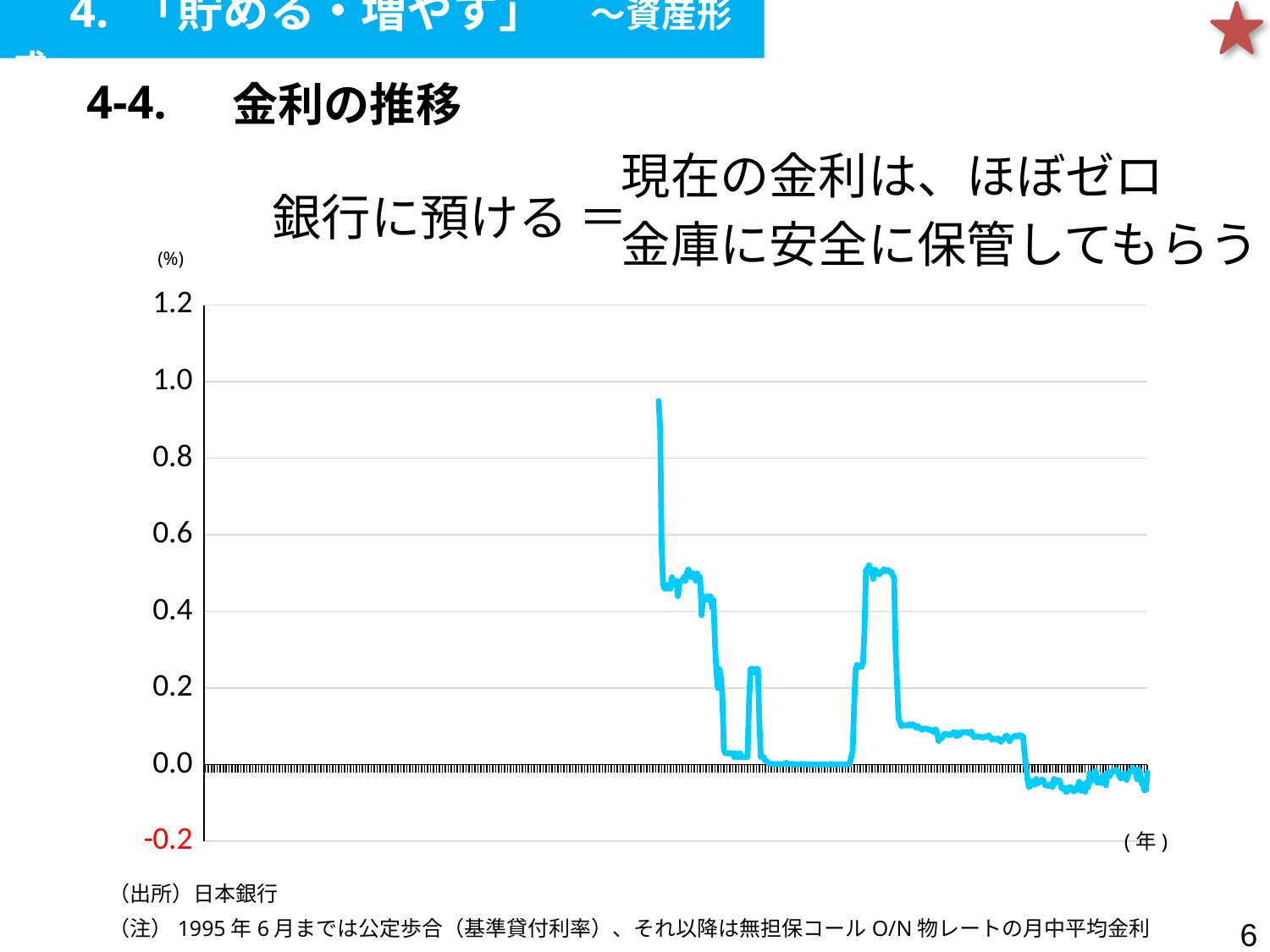
What kind of chart is shown on the slide? line chart Is the highest value reached by the line greater or less than 0.8? greater Is the highest value reached by the line greater or less than 1.0? less What is the highest value labelled on the vertical axis? 1.2 Overall, does the interest rate line rise or fall from left to right along the x axis? fall What is the title of the chart section on the slide? 金利の推移 Is the value of the line at the far right end of the chart greater or less than 0.2? less What is the lowest value labelled on the vertical axis? -0.2